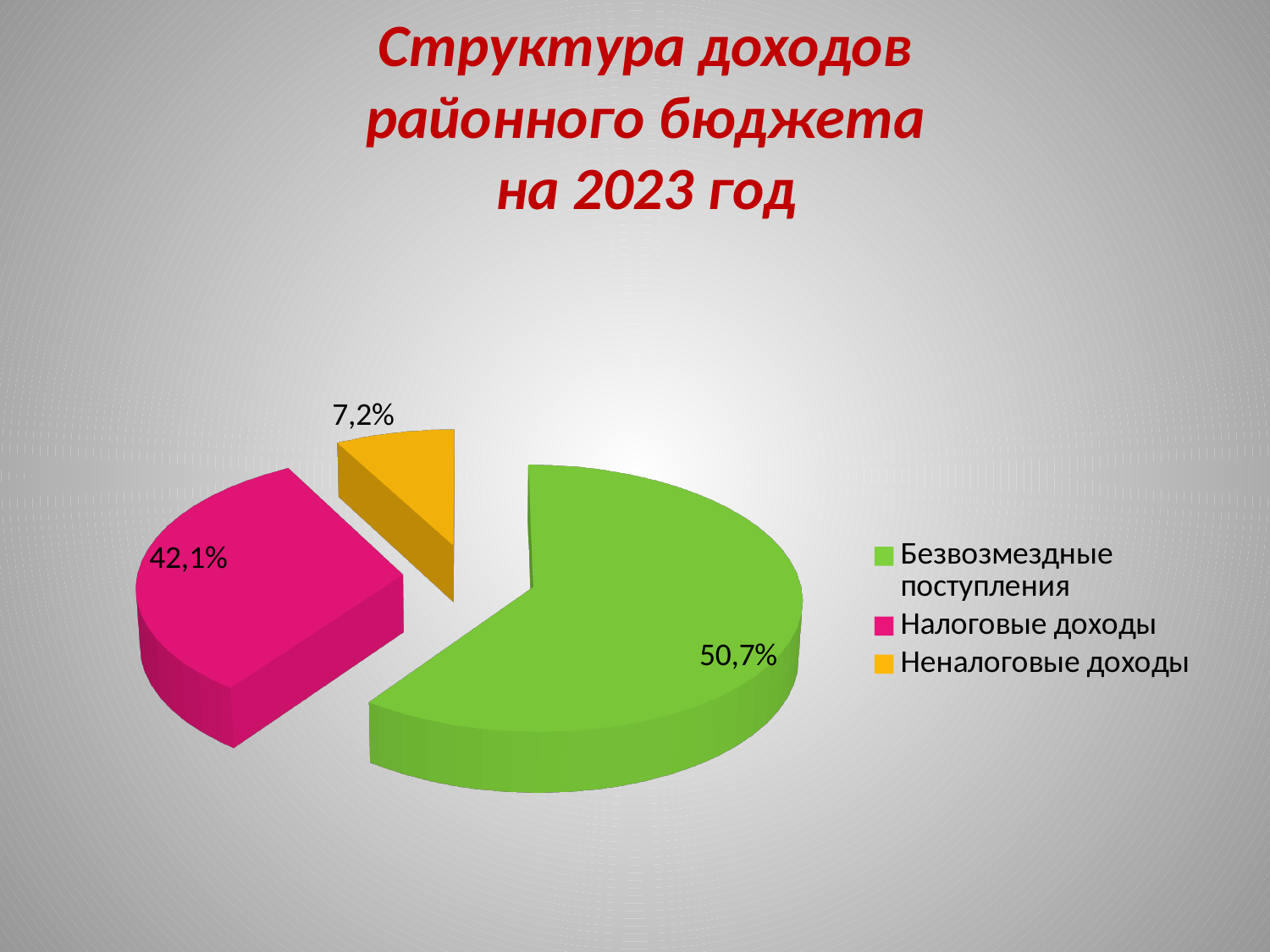
What share of the pie does Безвозмездные поступления have? 50,7% What colour is the slice for Налоговые доходы? Pink Which category has the largest slice of the pie? Безвозмездные поступления What is the title of the chart on the slide? Структура доходов районного бюджета на 2023 год Which category has the smallest slice of the pie? Неналоговые доходы What share of the pie does Неналоговые доходы have? 7,2% What is the difference in percentage points between Безвозмездные поступления and Налоговые доходы? 8,6 How many slices does the pie chart have? 3 What is the difference in percentage points between Налоговые доходы and Неналоговые доходы? 34,9 What share of the pie does Налоговые доходы have? 42,1% What kind of chart is shown on the slide? Pie chart Which is larger: Налоговые доходы or Неналоговые доходы? Налоговые доходы